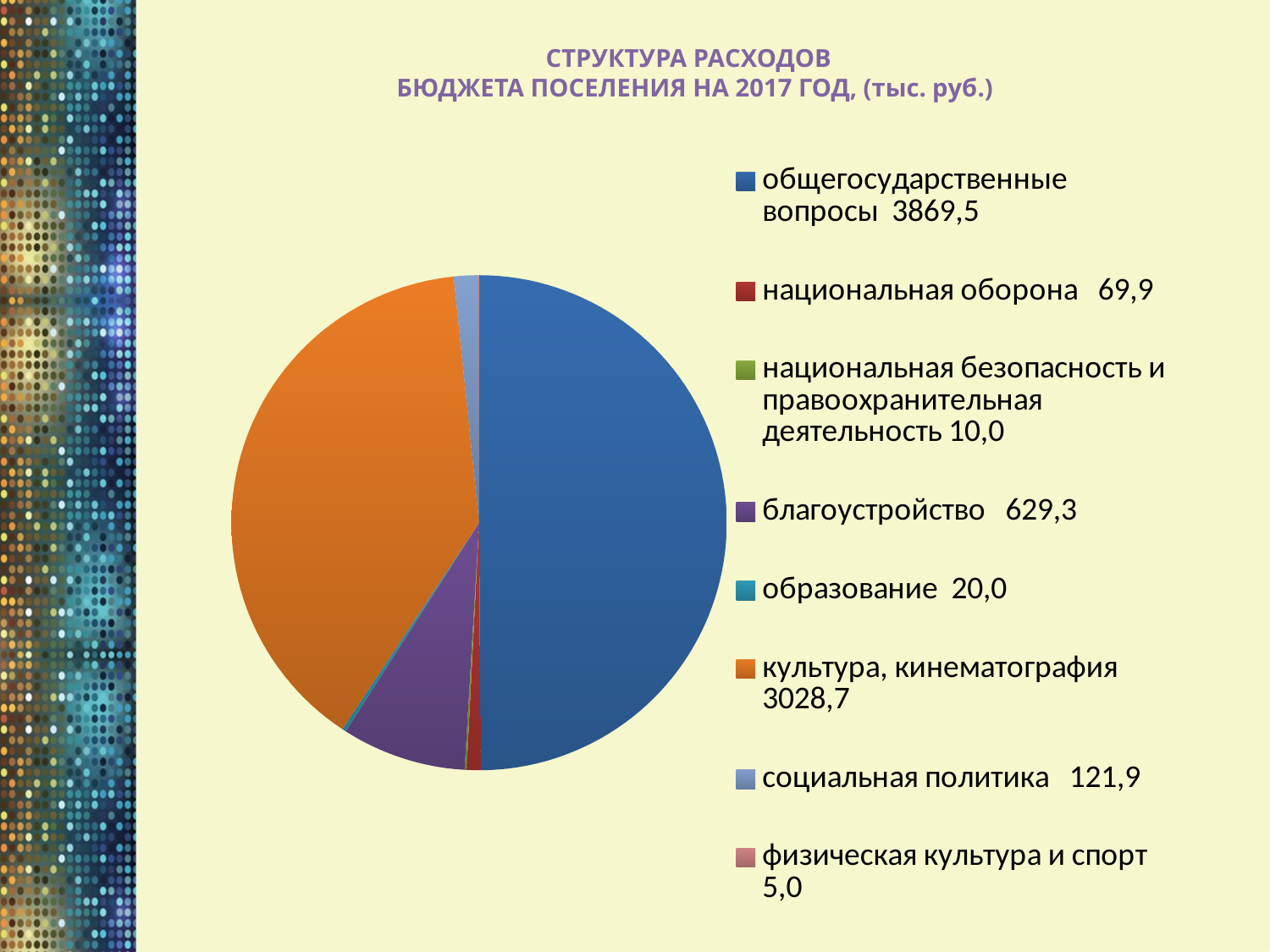
What type of chart is shown on the slide? pie chart What is the difference between благоустройство and социальная политика? 507,4 Which category has the smallest value? физическая культура и спорт What is the value for общегосударственные вопросы? 3869,5 What is the value for благоустройство? 629,3 Which category has the largest value? общегосударственные вопросы What is the title of the chart? СТРУКТУРА РАСХОДОВ БЮДЖЕТА ПОСЕЛЕНИЯ НА 2017 ГОД, (тыс. руб.) What is the value for социальная политика? 121,9 What is the difference between общегосударственные вопросы and культура, кинематография? 840,8 How many categories does the pie chart show? 8 What is the value for культура, кинематография? 3028,7 Which is larger, национальная оборона or образование? национальная оборона